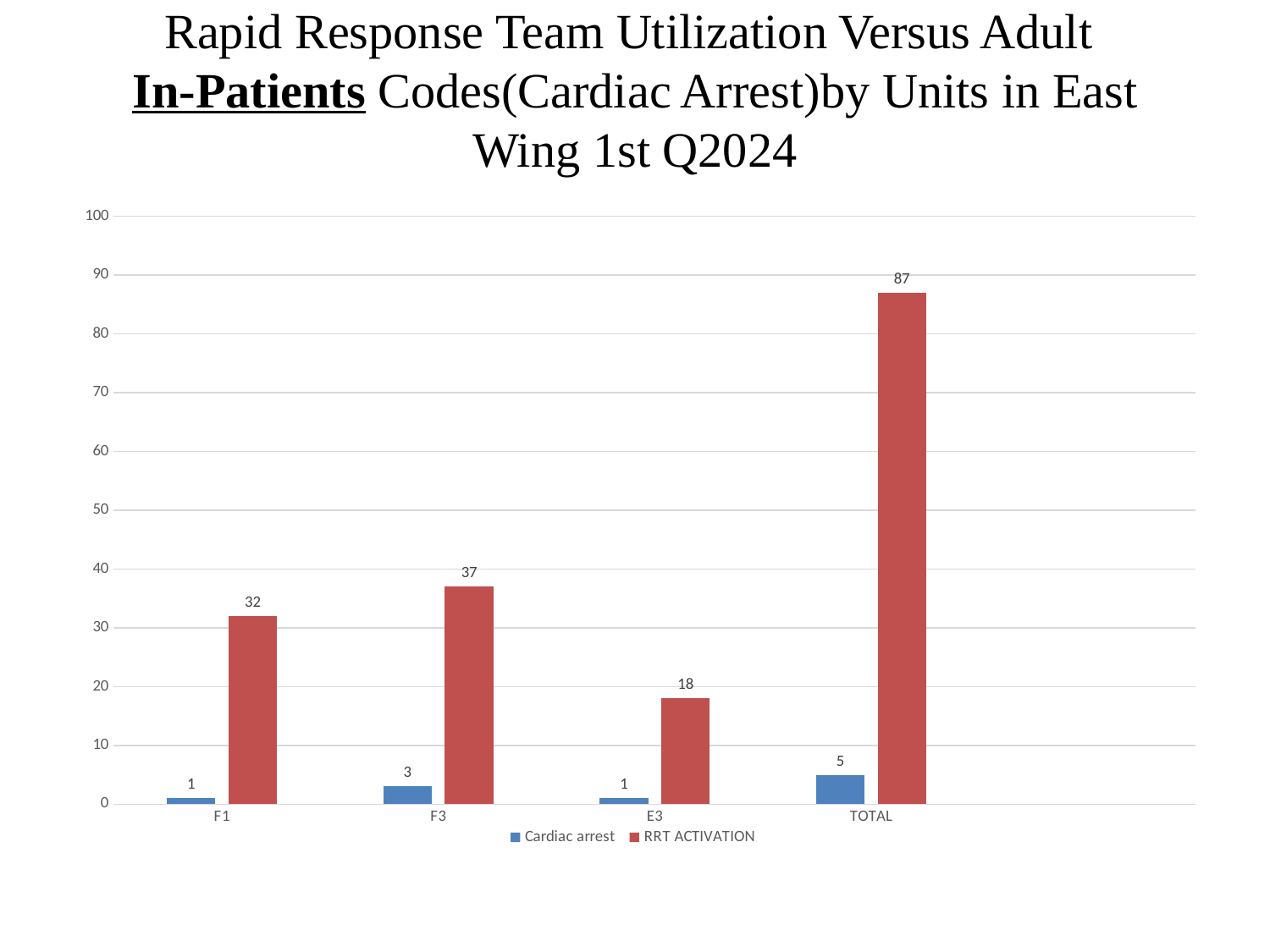
What kind of chart is shown on the slide? Bar chart Excluding TOTAL, which unit has the highest RRT ACTIVATION value? F3 Is the RRT ACTIVATION value for TOTAL greater or less than 80? greater Which is larger, the RRT ACTIVATION value for F1 or for E3? F1 What is the Cardiac arrest value for F3? 3 How many categories are shown on the x axis? 4 What is the RRT ACTIVATION value for F3? 37 Excluding TOTAL, which unit has the lowest RRT ACTIVATION value? E3 How many series does the legend list? 2 What is the RRT ACTIVATION value for E3? 18 What is the difference between the RRT ACTIVATION values for F3 and F1? 5 What is the Cardiac arrest value for TOTAL? 5